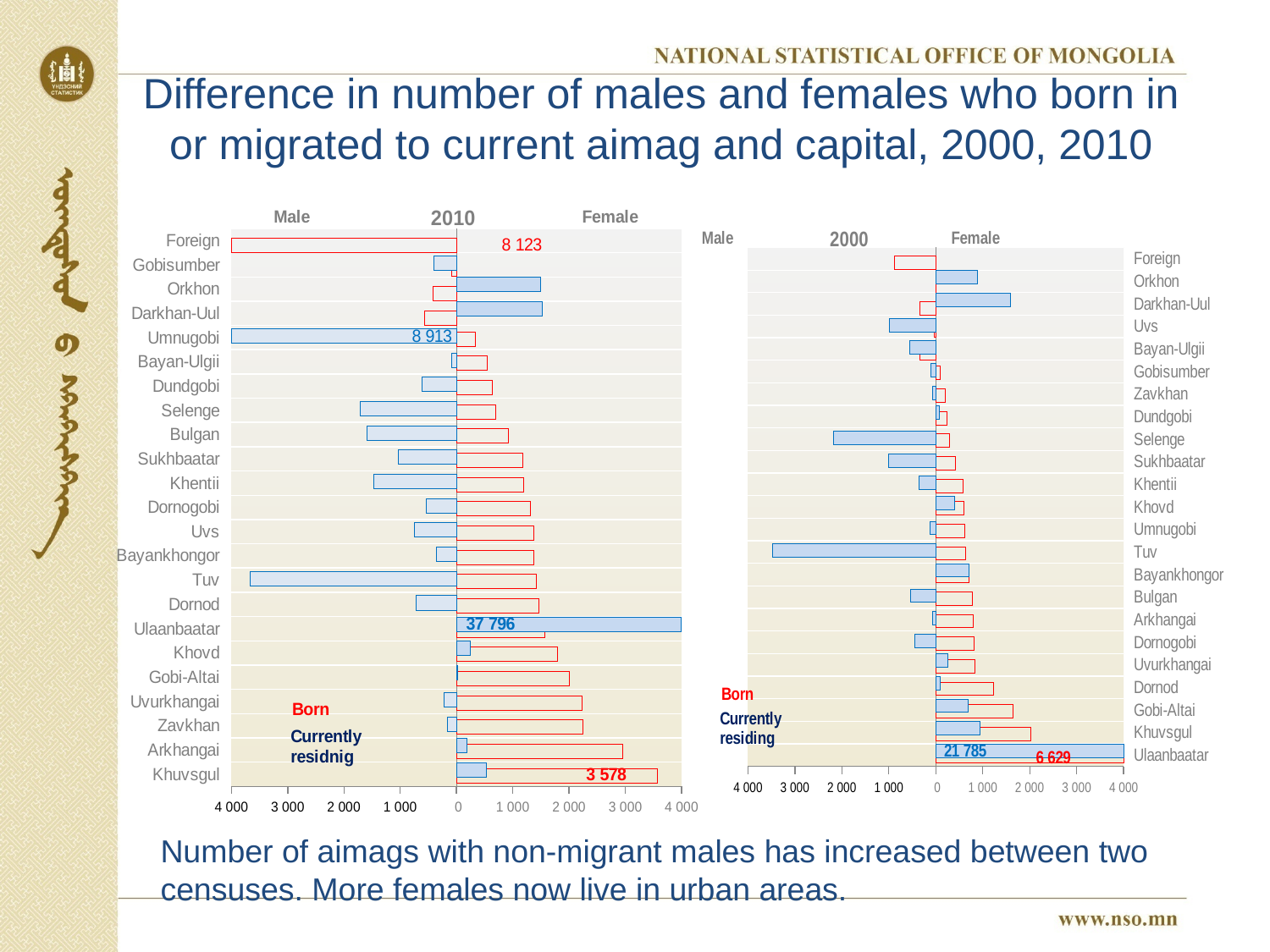
What kind of chart is the 2000 chart? Bar chart In the 2000 chart, what is the labelled 'Born' value for Ulaanbaatar? 6 629 In the 2000 chart, what is the labelled 'Currently residing' value for Ulaanbaatar? 21 785 What are the two legend entries shown on the 2010 chart? Born; Currently residing In the 2000 chart, what is the difference between the two labelled Ulaanbaatar values, 21 785 and 6 629? 15 156 In the 2010 chart, is the male 'Currently residing' bar for Tuv greater or less than 3 000? greater In the 2010 chart, what value is labelled for Umnugobi on the male side? 8 913 In the 2010 chart, what value is labelled for Ulaanbaatar on the female side? 37 796 In the 2000 chart, is the male 'Currently residing' bar for Tuv greater or less than 3 000? greater How many series does the legend of the 2010 chart list? 2 In the 2010 chart, what value is labelled for Khuvsgul on the female side? 3 578